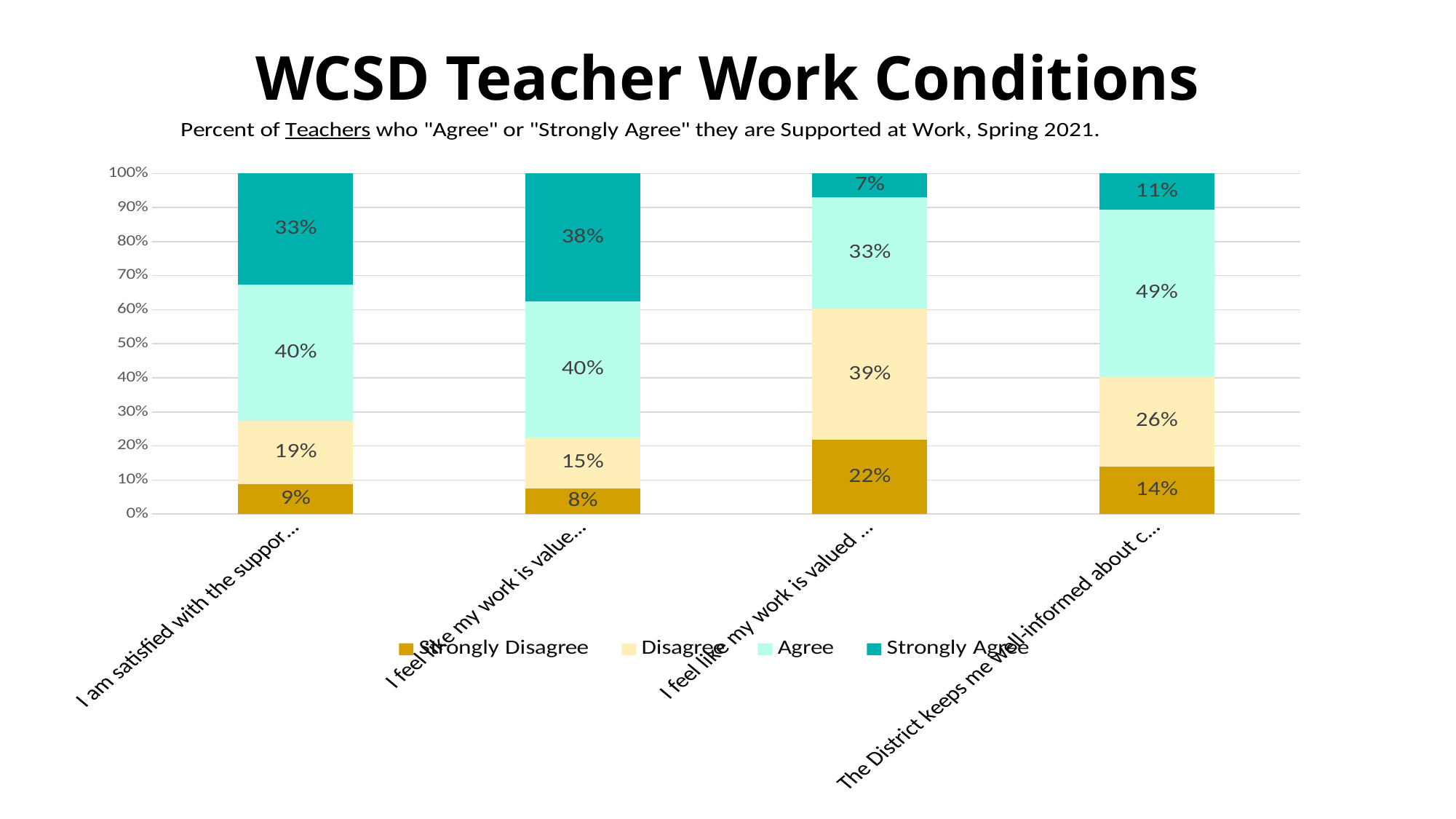
What is the difference between the "Agree" value of the fourth bar and the "Agree" value of the third bar? 16% What is the "Strongly Agree" value for the first bar, "I am satisfied with the suppor..."? 33% What is the "Strongly Disagree" value for the third bar from the left? 22% What is the combined "Agree" and "Strongly Agree" share for the first bar, "I am satisfied with the suppor..."? 73% What is the "Disagree" value for the second bar from the left? 15% Which bar has the lowest "Strongly Agree" value? The third bar (7%) How many series does the legend list? 4 What kind of chart is shown on the slide? Stacked bar chart Which bar has the highest "Strongly Agree" value? The second bar (38%) What is the "Agree" value for the fourth bar, "The District keeps me well-informed about c..."? 49% How many categories (bars) are plotted in the chart? 4 Which is larger: the "Disagree" value of the first bar or the "Disagree" value of the fourth bar? The fourth bar (26%)